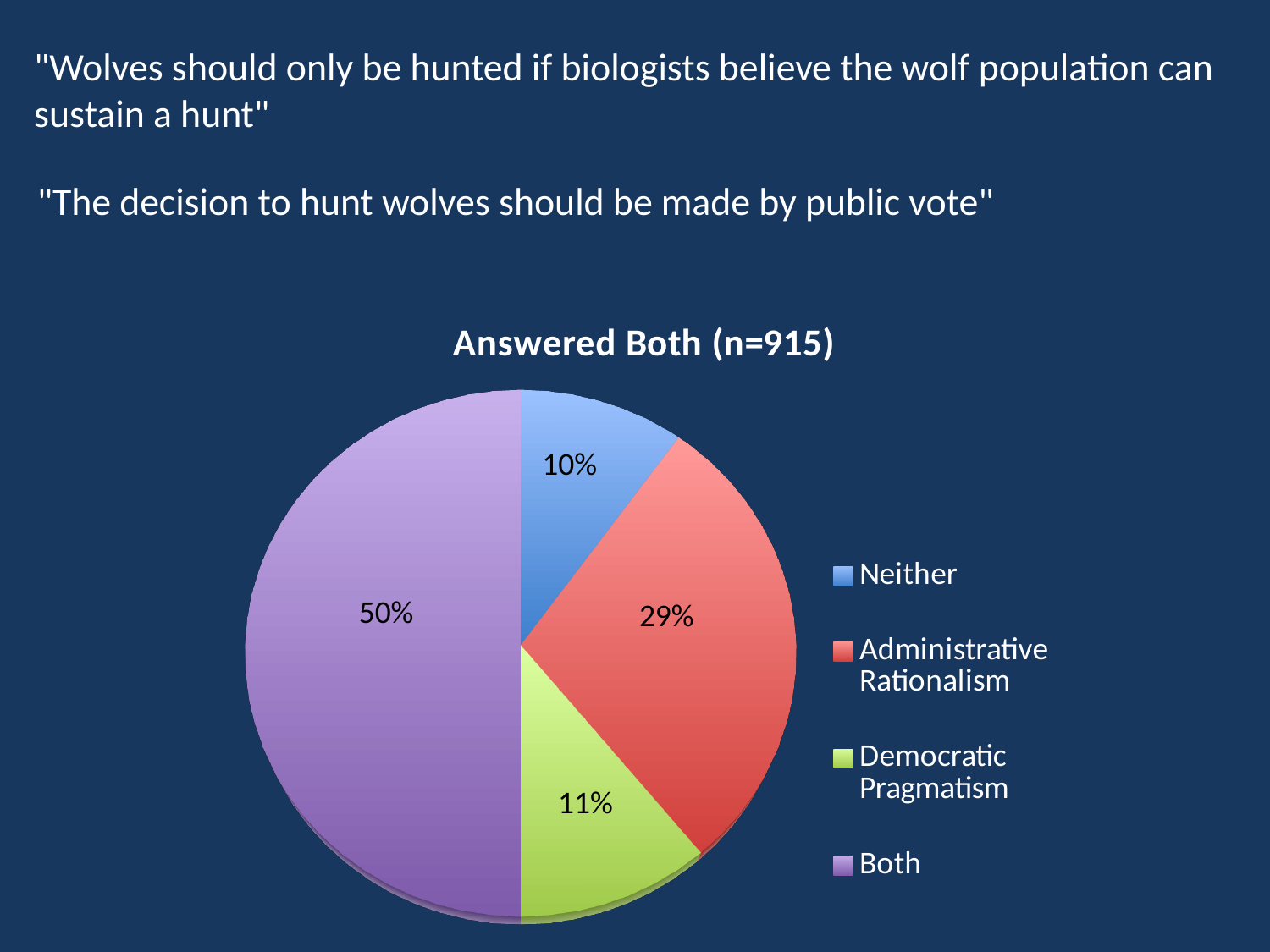
What kind of chart is shown on the slide? pie chart Which category has the smallest slice of the pie? Neither What share of the pie is labelled Administrative Rationalism? 29% Which category has the largest slice of the pie? Both What colour is the Both slice? purple What is the difference in percentage points between the Both slice and the Administrative Rationalism slice? 21 What share of the pie is labelled Democratic Pragmatism? 11% What is the title of the chart? Answered Both (n=915) How many categories does the legend list? 4 What share of the pie is labelled Both? 50% Which slice is larger, Administrative Rationalism or Democratic Pragmatism? Administrative Rationalism What share of the pie is labelled Neither? 10%